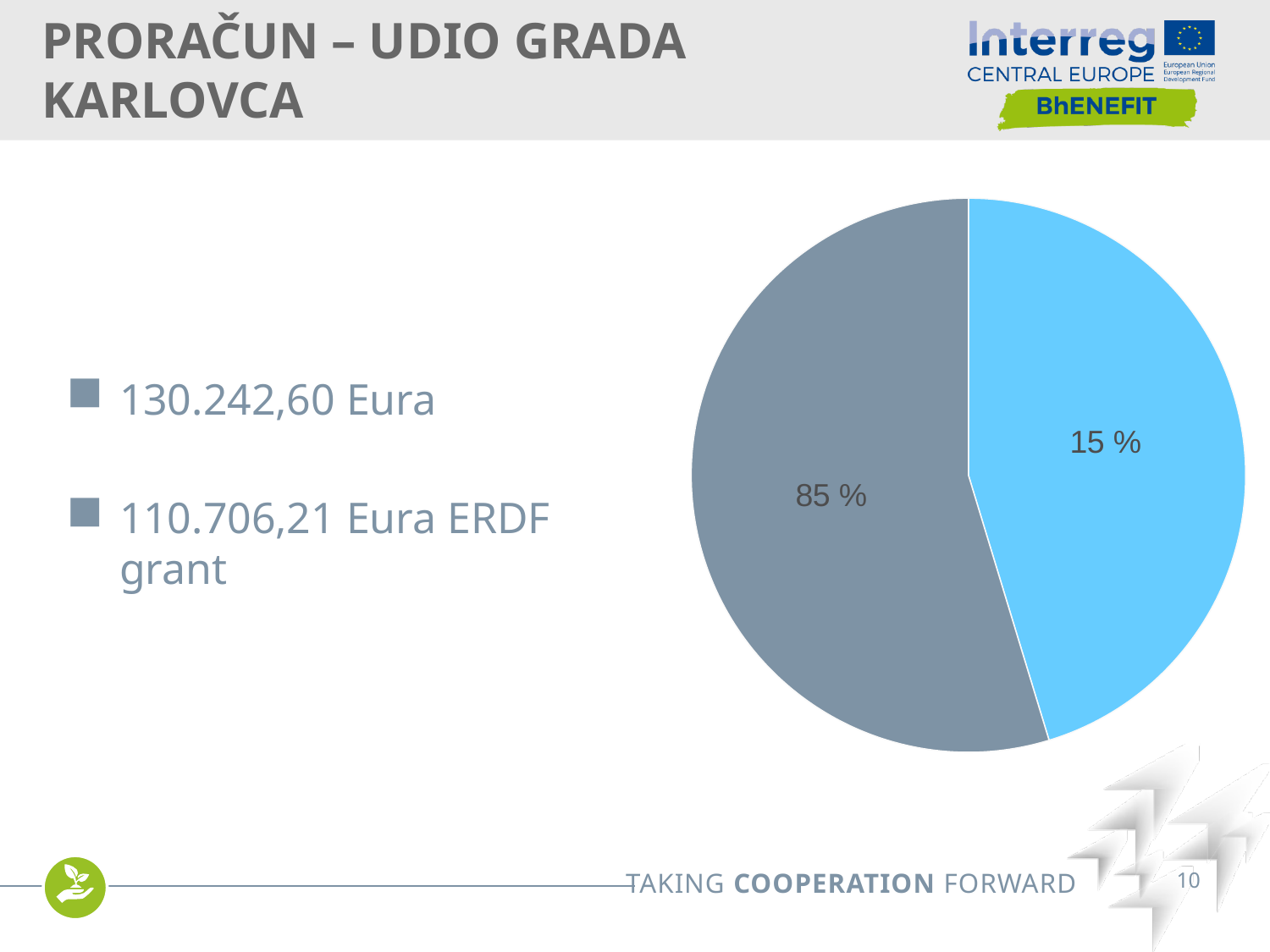
Which is larger, the grey slice or the blue slice of the pie chart? the grey slice What share of the pie does the blue slice represent? 15 % What share of the pie does the grey slice represent? 85 % What kind of chart is shown on the slide? pie chart What percentage is shown on the grey slice of the pie chart? 85 % What is the difference in percentage points between the grey slice and the blue slice? 70 Does the pie chart have a legend? No Which slice of the pie chart is the largest? the grey slice (85 %) What percentage is shown on the blue slice of the pie chart? 15 % How many slices does the pie chart have? 2 What colour is the slice labelled 15 %? blue Which slice of the pie chart is the smallest? the blue slice (15 %)